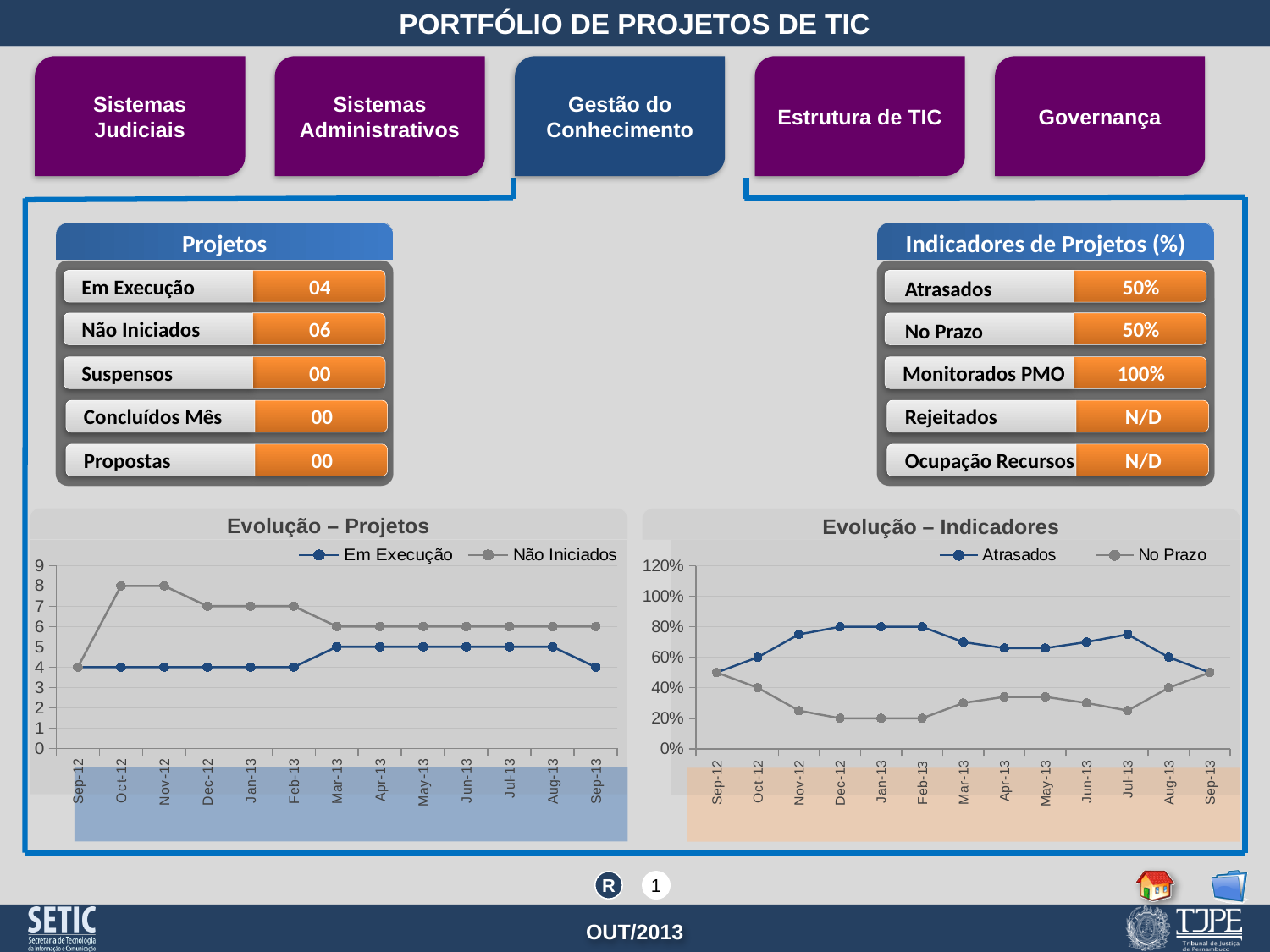
On the 'Evolução – Projetos' chart, what is the value for Não Iniciados in Oct-12? 8 On the 'Evolução – Indicadores' chart, does the No Prazo series rise or fall from Sep-12 to Dec-12? Fall On the 'Evolução – Projetos' chart, how many months are plotted on the x axis? 13 On the 'Evolução – Indicadores' chart, what is the value for No Prazo in Oct-12? 40% On the 'Evolução – Projetos' chart, what is the value for Não Iniciados in Sep-13? 6 On the 'Evolução – Projetos' chart, what is the value for Em Execução in Mar-13? 5 On the 'Evolução – Indicadores' chart, what is the value for Atrasados in Dec-12? 80% On the 'Evolução – Projetos' chart, how many series does the legend list? 2 What kind of chart is 'Evolução – Indicadores'? Line chart On the 'Evolução – Projetos' chart, what is the difference between Não Iniciados and Em Execução in Nov-12? 4 On the 'Evolução – Indicadores' chart, which series is higher in Feb-13, Atrasados or No Prazo? Atrasados On the 'Evolução – Indicadores' chart, is the value for No Prazo in Jan-13 greater or less than 40%? less